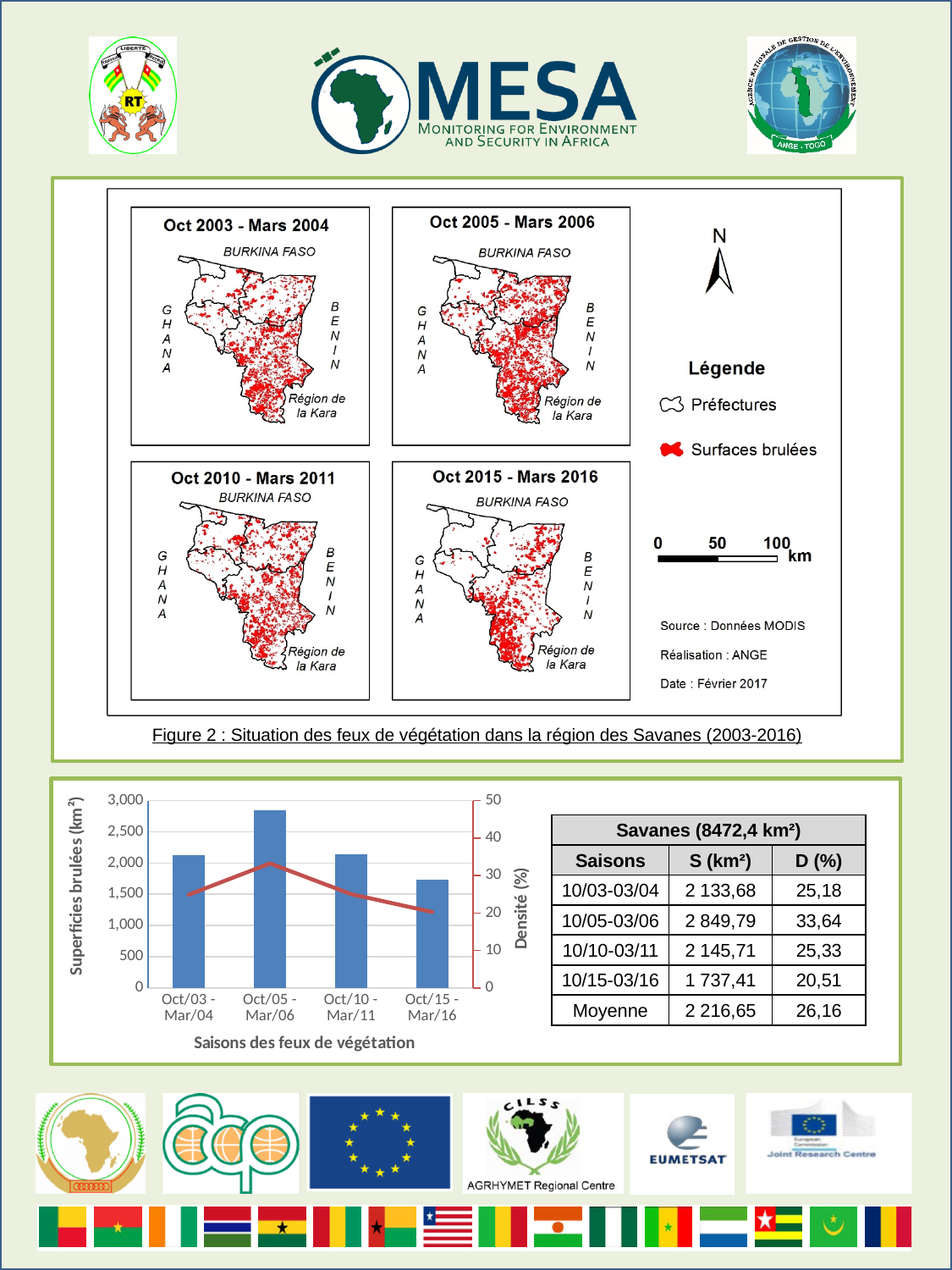
In the bottom chart, is the burned-area bar for Oct/05 - Mar/06 greater or less than 2,500 km²? greater How does the density line in the bottom chart change from Oct/05 - Mar/06 to Oct/15 - Mar/16? it falls Which has the larger burned-area bar in the bottom chart: Oct/03 - Mar/04 or Oct/15 - Mar/16? Oct/03 - Mar/04 In the bottom chart, is the density (Densité) value for Oct/15 - Mar/16 greater or less than 25%? less In the bottom chart, is the burned-area bar for Oct/15 - Mar/16 greater or less than 2,000 km²? less What is the title of the left vertical axis of the bottom chart? Superficies brulées (km²) According to the table beside the bottom chart, what is the burned area S (km²) for the 10/05-03/06 season? 2 849,79 According to the table beside the bottom chart, what is the density D (%) for the 10/15-03/16 season? 20,51 What kind of chart is shown at the bottom of the slide? bar chart with a line overlay Which season has the tallest bar for burned area (Superficies brulées) in the bottom chart? Oct/05 - Mar/06 Which season has the shortest bar for burned area in the bottom chart? Oct/15 - Mar/16 How many fire seasons are plotted along the x axis of the bottom chart? 4